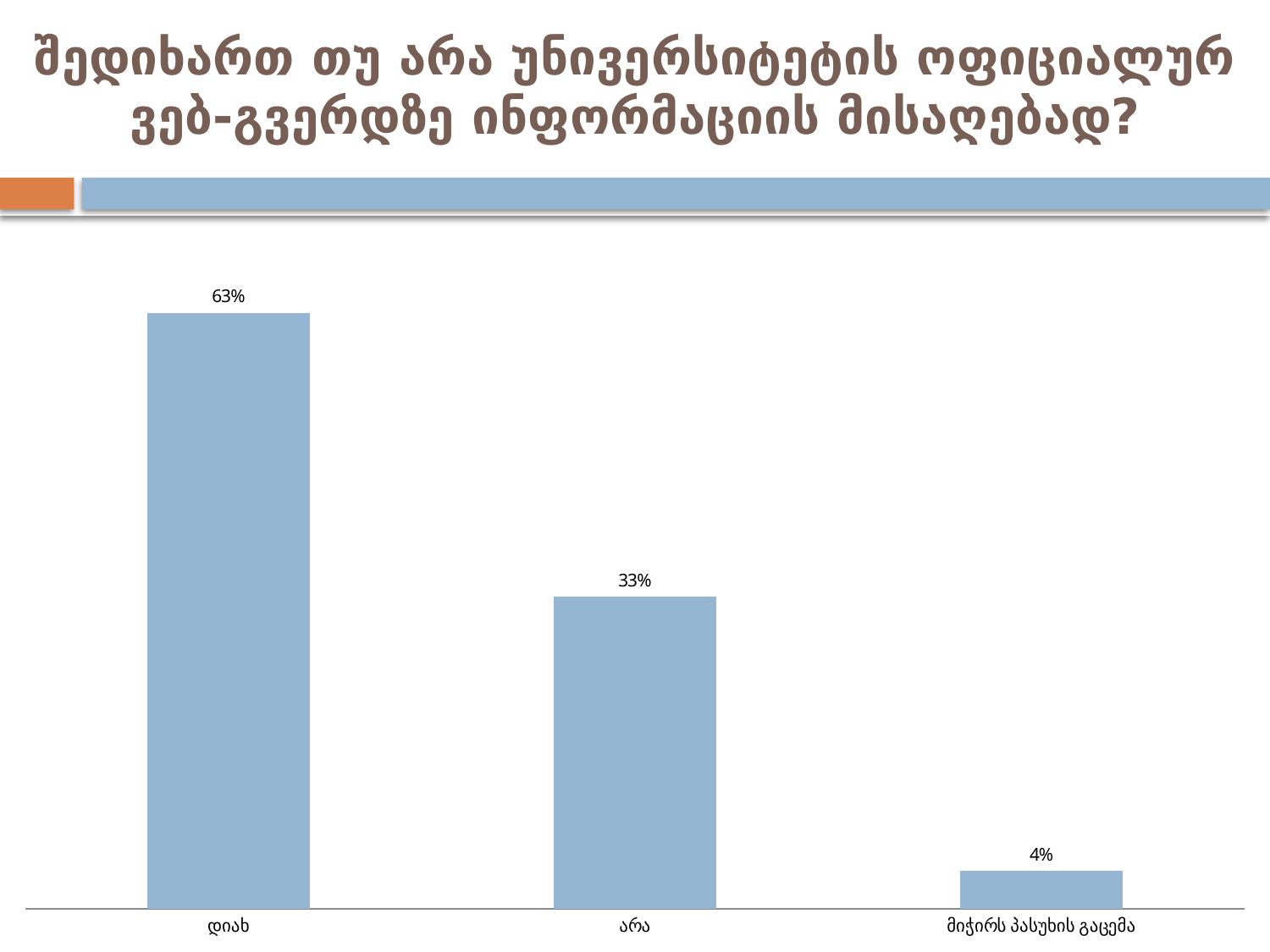
Which category has the lowest value? მიჭირს პასუხის გაცემა What is the title of the slide? შედიხართ თუ არა უნივერსიტეტის ოფიციალურ ვებ-გვერდზე ინფორმაციის მისაღებად? What is the value for მიჭირს პასუხის გაცემა? 4% What is the value for დიახ? 63% Do the values rise or fall from left to right along the x axis? fall Which is larger, the value for დიახ or the value for არა? დიახ What is the difference between the values for დიახ and არა? 30% How many categories are shown in the chart? 3 What kind of chart is shown on the slide? bar chart What is the value for არა? 33% Which category has the highest value? დიახ What is the difference between the values for არა and მიჭირს პასუხის გაცემა? 29%